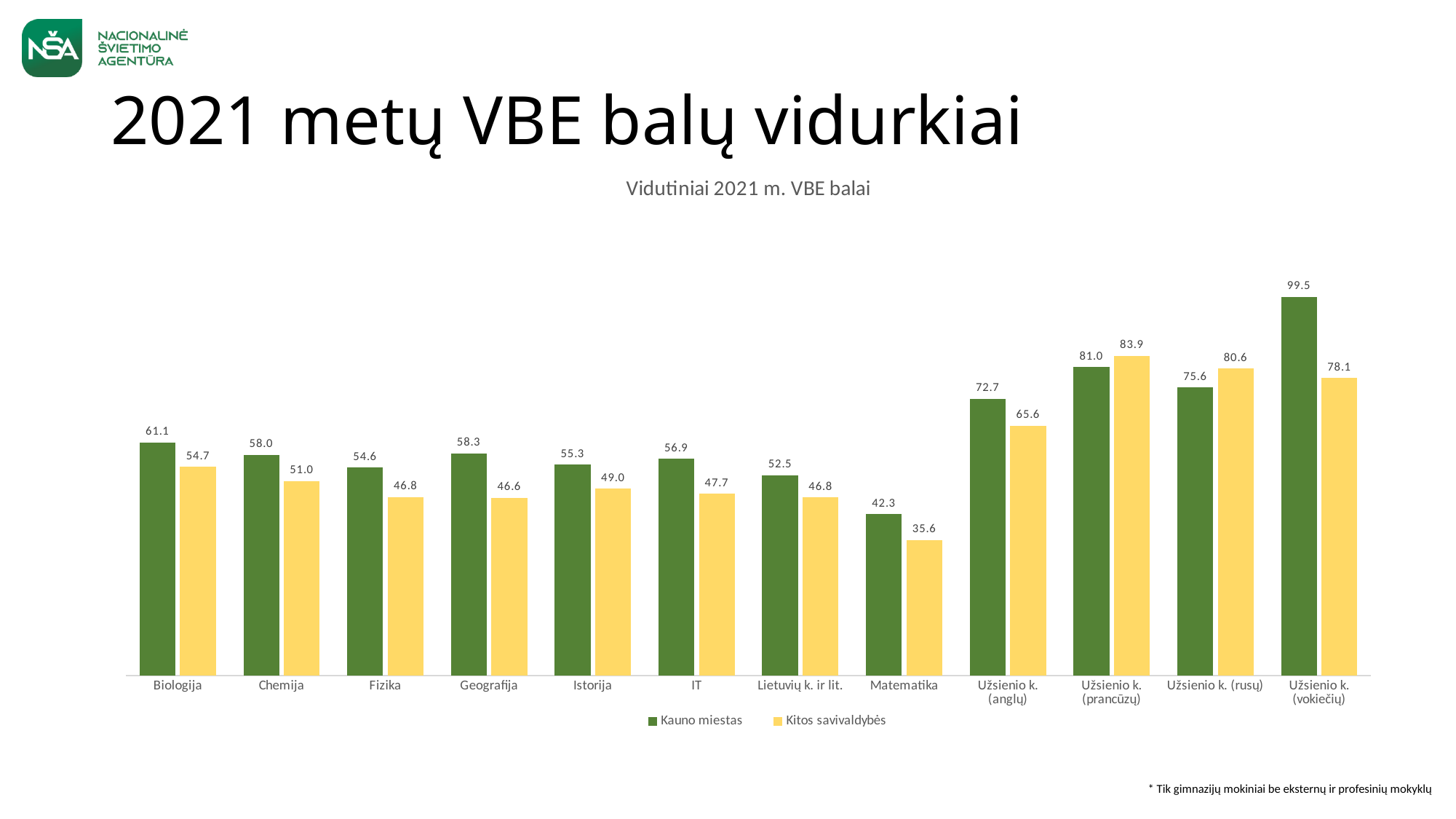
What is the value for Kitos savivaldybės in Užsienio k. (prancūzų)? 83.9 What is the difference between the Kauno miestas and Kitos savivaldybės values for Užsienio k. (vokiečių)? 21.4 What is the value for Kitos savivaldybės in Istorija? 49.0 What kind of chart is shown on the slide? Bar chart How many series does the legend list? 2 What is the difference between the Kauno miestas values for Biologija and Chemija? 3.1 What is the title of the chart? Vidutiniai 2021 m. VBE balai Which is larger in Užsienio k. (rusų): the value for Kauno miestas or for Kitos savivaldybės? Kitos savivaldybės How many subject categories are shown on the x axis? 12 Which category has the highest value for Kauno miestas? Užsienio k. (vokiečių) Which category has the lowest value for Kitos savivaldybės? Matematika What is the value for Kauno miestas in Matematika? 42.3